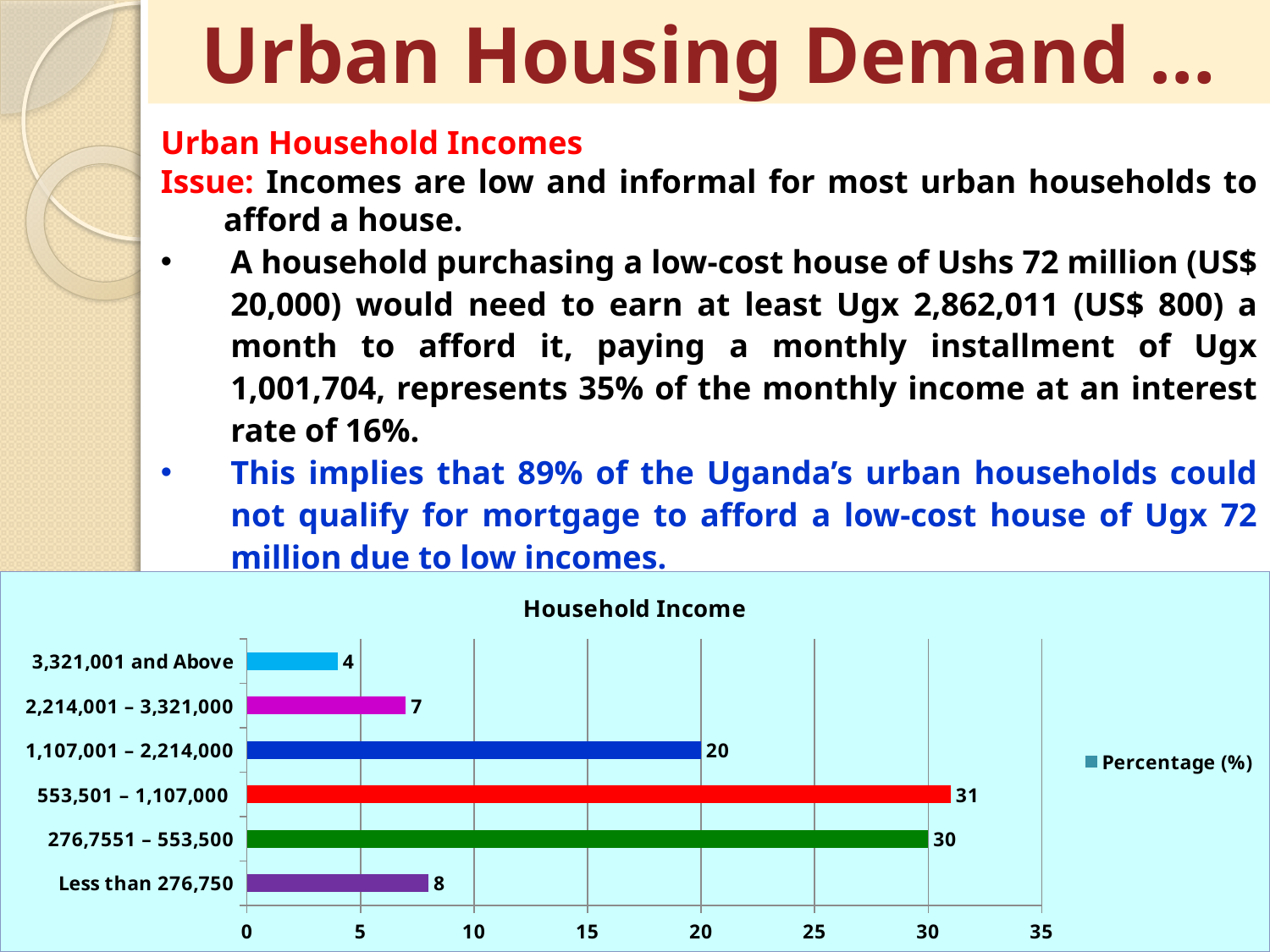
What is the difference between the values for '1,107,001 – 2,214,000' and '2,214,001 – 3,321,000'? 13 What kind of chart is shown on the slide? bar chart How many income categories are shown in the chart? 6 What is the value for the 'Less than 276,750' income category? 8 How many series does the legend list? 1 What is the value for the '3,321,001 and Above' income category? 4 Which income category has the highest value? 553,501 – 1,107,000 What is the value for the '553,501 – 1,107,000' income category? 31 What is the title of the chart? Household Income Which is larger, the value for '276,7551 – 553,500' or the value for '1,107,001 – 2,214,000'? 276,7551 – 553,500 Which income category has the lowest value? 3,321,001 and Above Is the value for '1,107,001 – 2,214,000' greater or less than 25? less